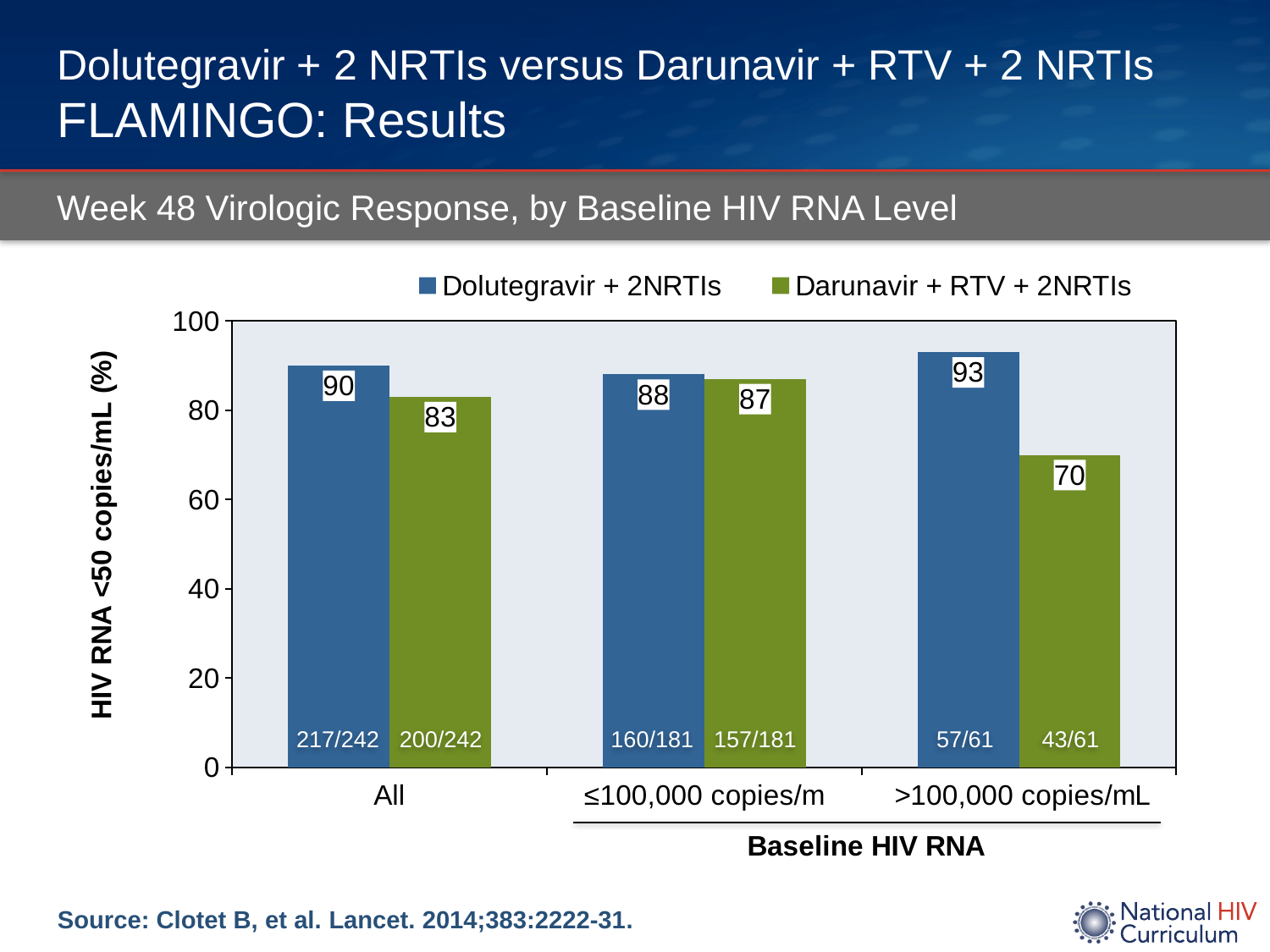
Is the value for Darunavir + RTV + 2NRTIs in the >100,000 copies/mL category greater or less than 80? less What is the value for Darunavir + RTV + 2NRTIs in the ≤100,000 copies/m category? 87 Which category has the lowest value for Darunavir + RTV + 2NRTIs? >100,000 copies/mL What is the value for Dolutegravir + 2NRTIs in the All category? 90 How many categories are shown on the x axis? 3 Which category has the highest value for Dolutegravir + 2NRTIs? >100,000 copies/mL Which series has the larger value in the All category? Dolutegravir + 2NRTIs How many series does the legend list? 2 What is the difference between Dolutegravir + 2NRTIs and Darunavir + RTV + 2NRTIs in the All category? 7 What is the difference between Dolutegravir + 2NRTIs and Darunavir + RTV + 2NRTIs in the >100,000 copies/mL category? 23 What is the value for Darunavir + RTV + 2NRTIs in the >100,000 copies/mL category? 70 What kind of chart is shown on the slide? bar chart